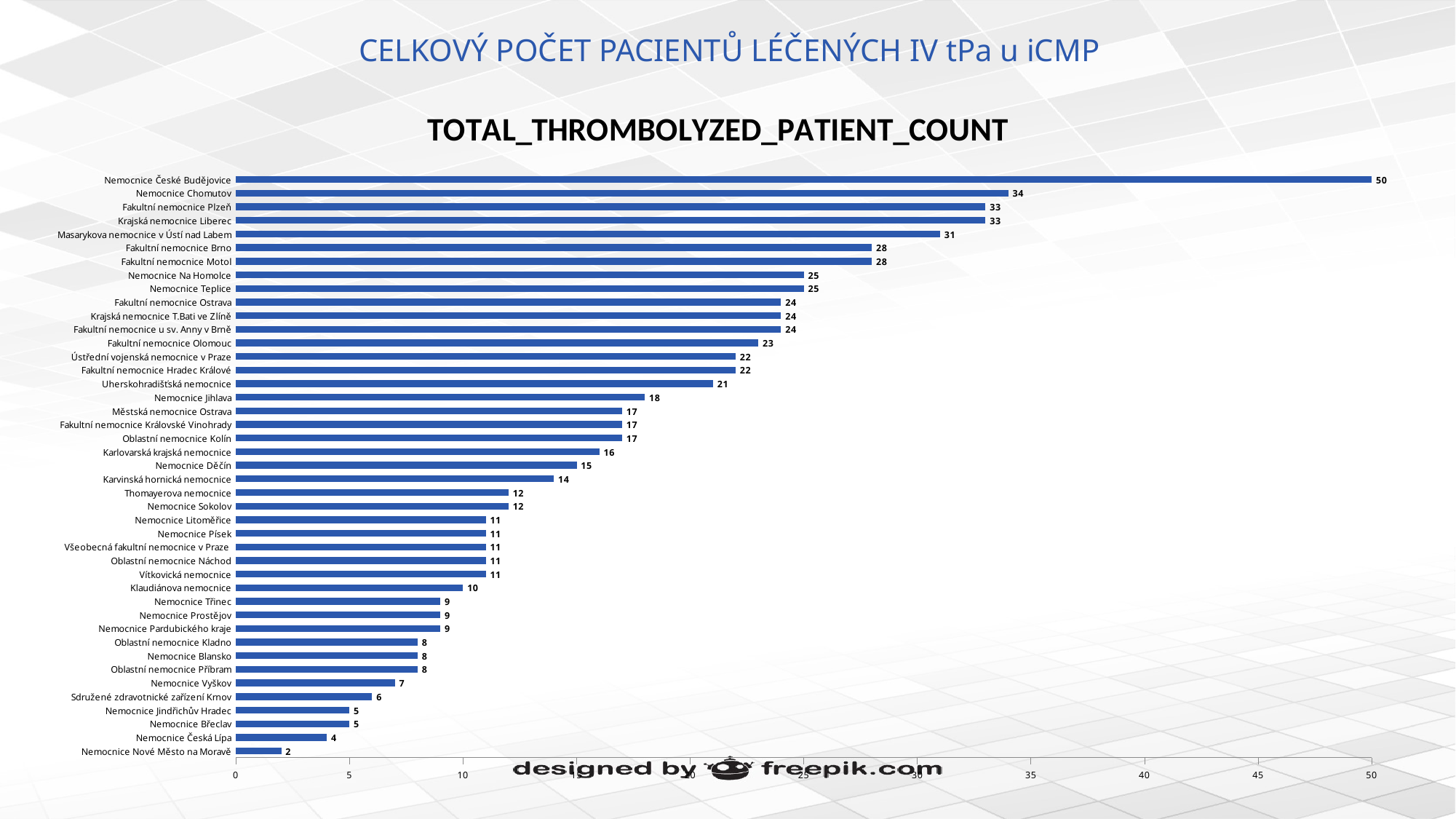
What is the value for Nemocnice Jihlava? 18 What is the value for Fakultní nemocnice Olomouc? 23 What is the difference between the values for Masarykova nemocnice v Ústí nad Labem and Nemocnice Děčín? 16 Which is larger, the value for Fakultní nemocnice Brno or the value for Nemocnice Teplice? Fakultní nemocnice Brno Which hospital has the highest value? Nemocnice České Budějovice What is the value for Nemocnice České Budějovice? 50 What is the difference between the values for Nemocnice České Budějovice and Nemocnice Chomutov? 16 How many hospitals are shown in the chart? 43 What is the value for Klaudiánova nemocnice? 10 Which hospital has the lowest value? Nemocnice Nové Město na Moravě What kind of chart is shown on the slide? Bar chart What is the title of the chart? TOTAL_THROMBOLYZED_PATIENT_COUNT